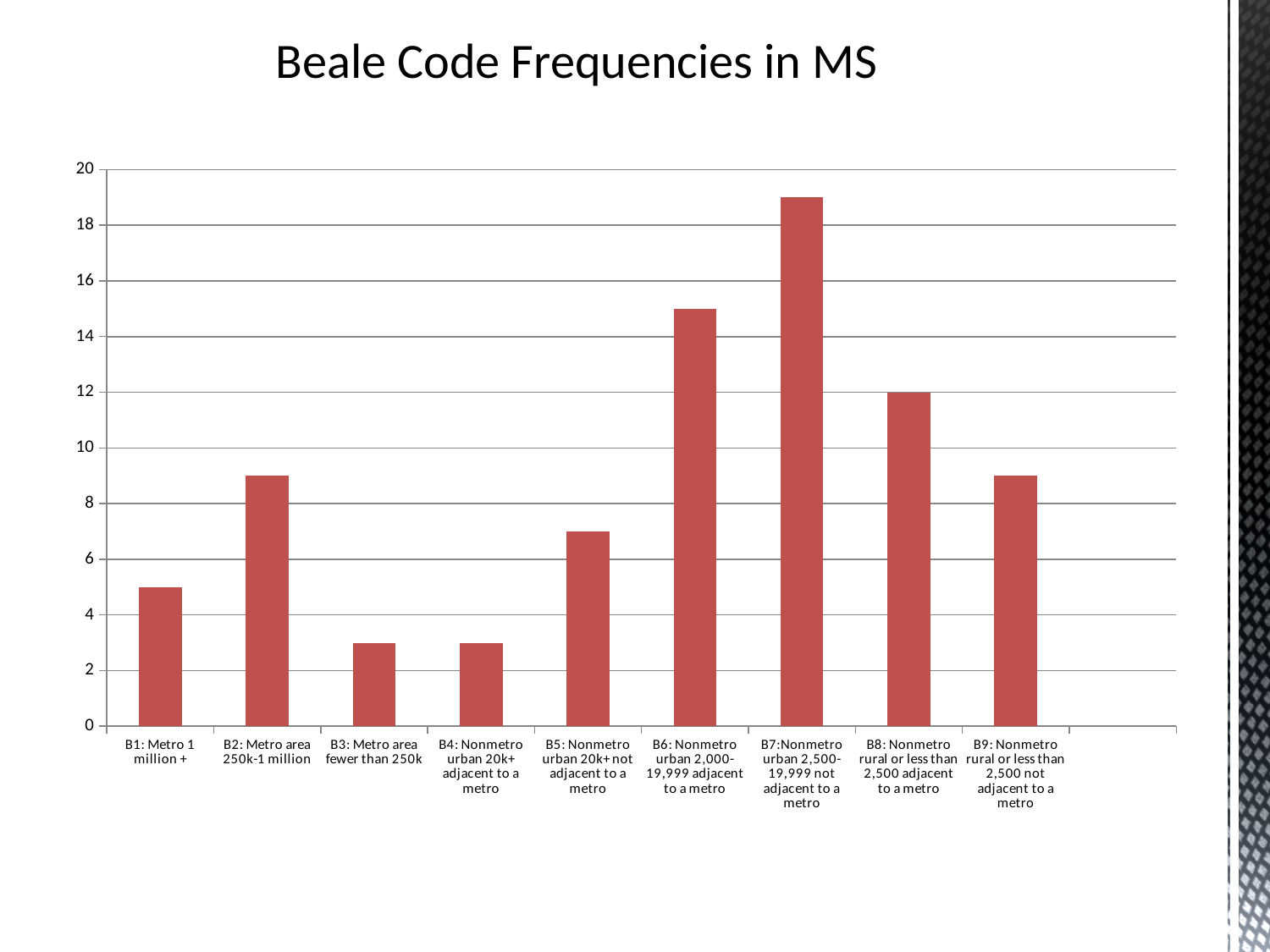
What is the title of the chart? Beale Code Frequencies in MS Which is larger, the value for B6: Nonmetro urban 2,000-19,999 adjacent to a metro or the value for B8: Nonmetro rural or less than 2,500 adjacent to a metro? B6: Nonmetro urban 2,000-19,999 adjacent to a metro Is the value for B6: Nonmetro urban 2,000-19,999 adjacent to a metro greater or less than 14? greater Is the value for B7: Nonmetro urban 2,500-19,999 not adjacent to a metro greater or less than 18? greater Which category has the highest frequency? B7: Nonmetro urban 2,500-19,999 not adjacent to a metro What type of chart is shown on the slide? bar chart How many Beale code categories are plotted on the chart? 9 Which is larger, the value for B2: Metro area 250k-1 million or the value for B3: Metro area fewer than 250k? B2: Metro area 250k-1 million What is the value for B8: Nonmetro rural or less than 2,500 adjacent to a metro? 12 What is the maximum value shown on the vertical axis? 20 Is the value for B1: Metro 1 million + greater or less than 6? less